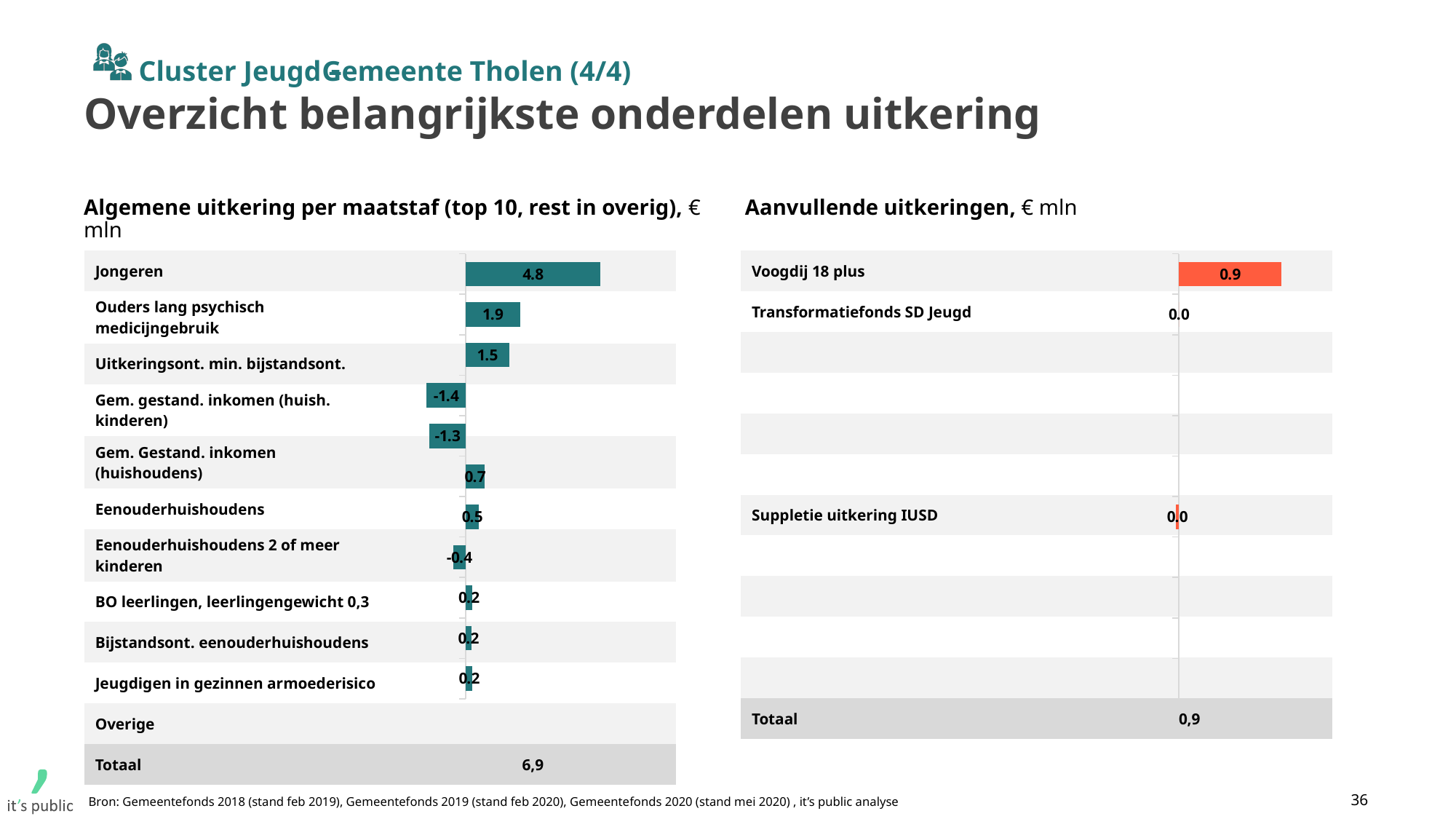
In the chart 'Aanvullende uitkeringen', what is the value for Transformatiefonds SD Jeugd? 0.0 In the chart 'Aanvullende uitkeringen', which category has the highest value? Voogdij 18 plus What kind of chart is the 'Algemene uitkering per maatstaf' chart on the left? bar chart In the chart 'Algemene uitkering per maatstaf', what is the difference between the values for Jongeren and Ouders lang psychisch medicijngebruik? 2.9 In the chart 'Aanvullende uitkeringen', what is the value for Voogdij 18 plus? 0.9 In the chart 'Algemene uitkering per maatstaf', what is the value for Jongeren? 4.8 In the chart 'Algemene uitkering per maatstaf', what is the value for Uitkeringsont. min. bijstandsont.? 1.5 In the chart 'Algemene uitkering per maatstaf', what is the value for Ouders lang psychisch medicijngebruik? 1.9 In the chart 'Algemene uitkering per maatstaf', what is the Totaal shown at the bottom? 6,9 In the chart 'Algemene uitkering per maatstaf', which is larger: Jongeren or Uitkeringsont. min. bijstandsont.? Jongeren In the chart 'Aanvullende uitkeringen', what is the Totaal shown at the bottom? 0,9 In the chart 'Algemene uitkering per maatstaf', which category has the highest value? Jongeren